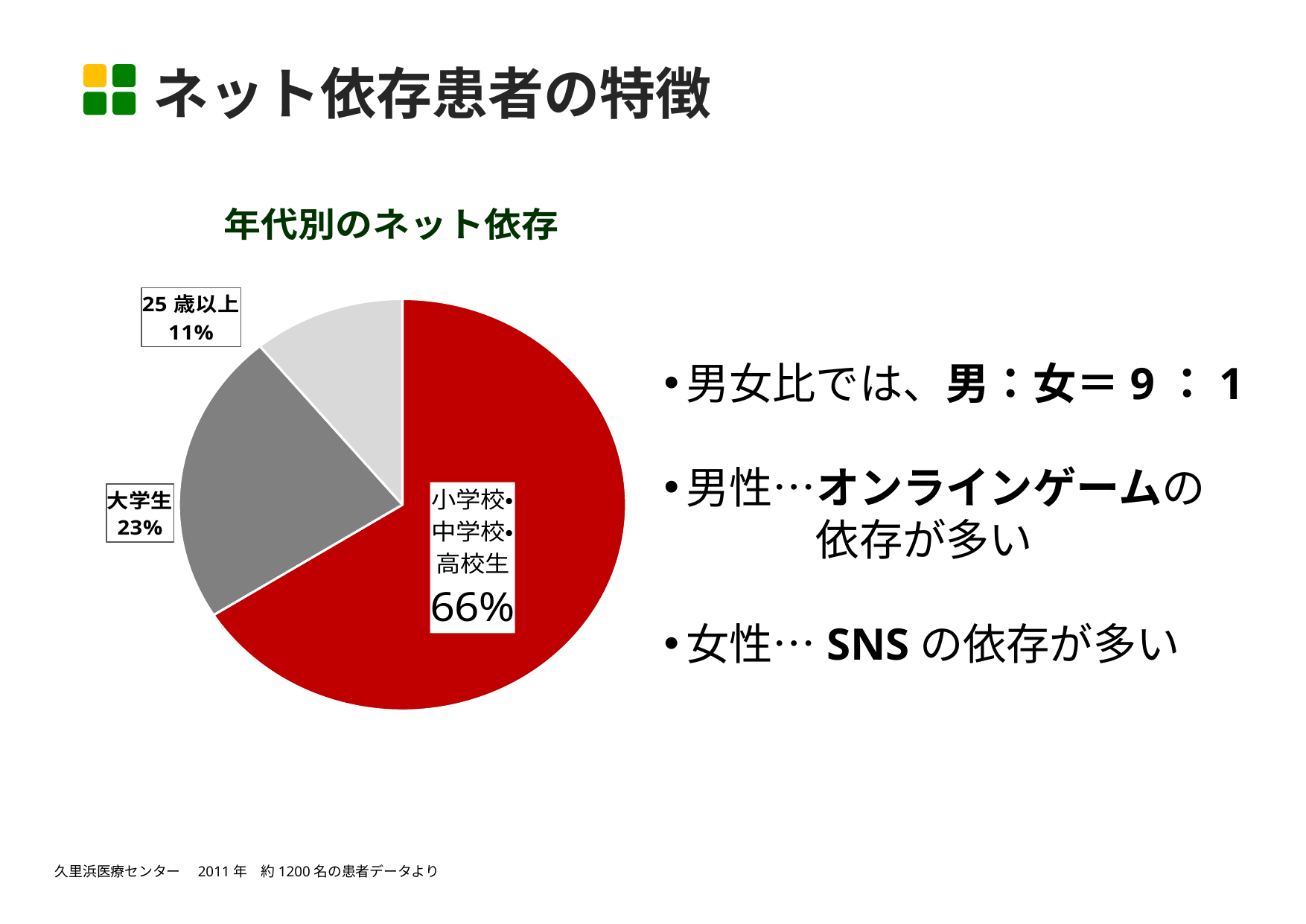
What is the difference in percentage points between the 小学校・中学校・高校生 slice and the 大学生 slice? 43 What type of chart is shown on the slide? pie chart What colour is the 小学校・中学校・高校生 slice? red Which category has the largest share of the pie? 小学校・中学校・高校生 Which is larger, the 大学生 slice or the 25歳以上 slice? 大学生 What percentage of the pie is labelled 25歳以上? 11% What percentage of the pie is labelled 小学校・中学校・高校生? 66% Which category has the smallest share of the pie? 25歳以上 What is the title of the chart? 年代別のネット依存 How many slices does the pie chart have? 3 What is the difference in percentage points between the 大学生 slice and the 25歳以上 slice? 12 What percentage of the pie is labelled 大学生? 23%